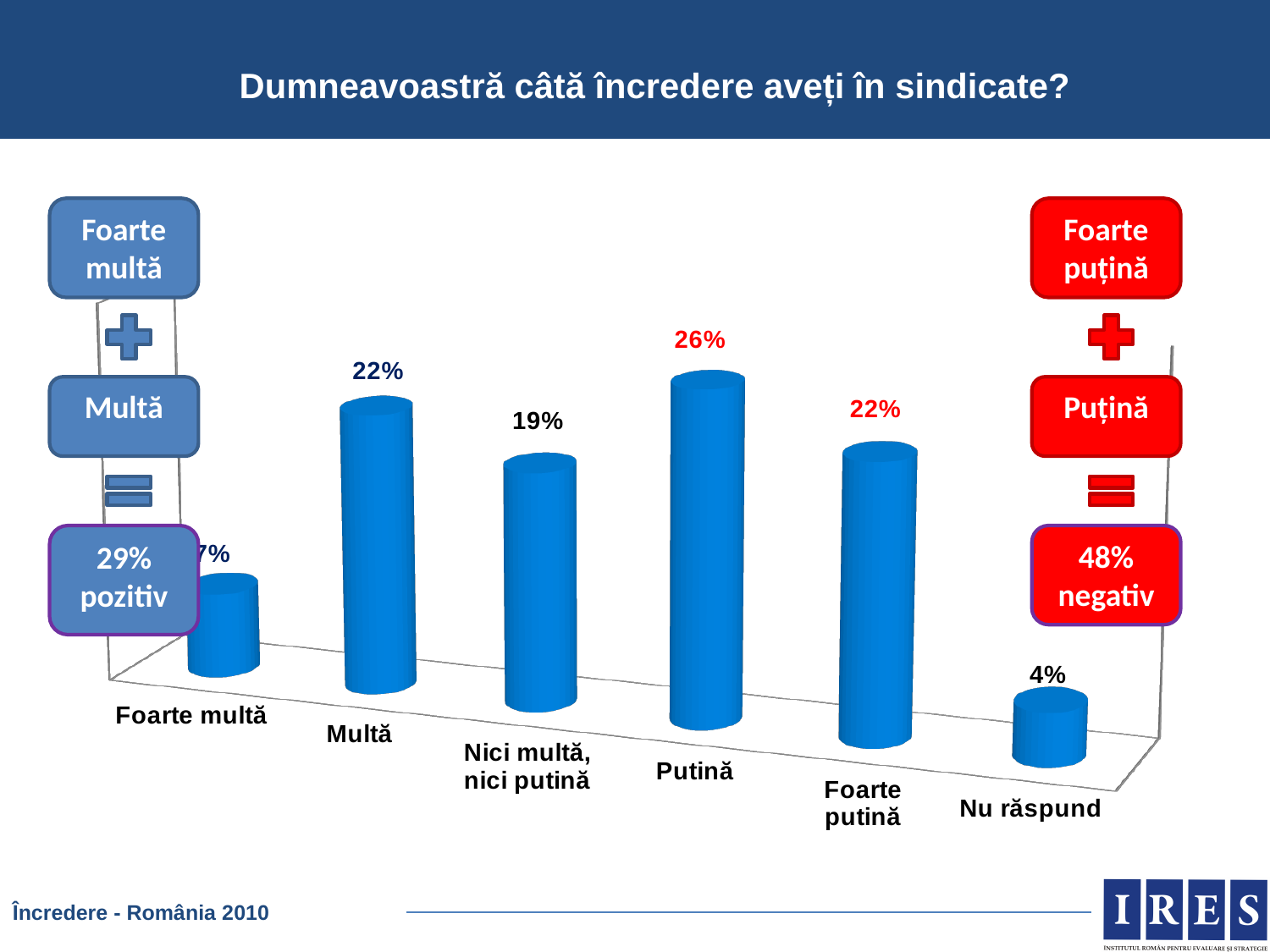
What percentage of respondents did not answer ("Nu răspund")? 4% Which category has the highest value? Puțină What percentage is shown for "Puțină"? 26% What kind of chart is shown on the slide? Bar chart What is the value shown for "Nici multă, nici puțină"? 19% What percentage of respondents answered "Multă"? 22% What is the difference between the values for "Puțină" and "Nici multă, nici puțină"? 7 percentage points How many categories are shown on the chart? 6 Which is larger, the value for "Puțină" or for "Foarte puțină"? Puțină Which category has the lowest value? Nu răspund According to the red box on the right, what is the combined negative share ("Foarte puțină" plus "Puțină")? 48% What is the value for "Foarte puțină"? 22%